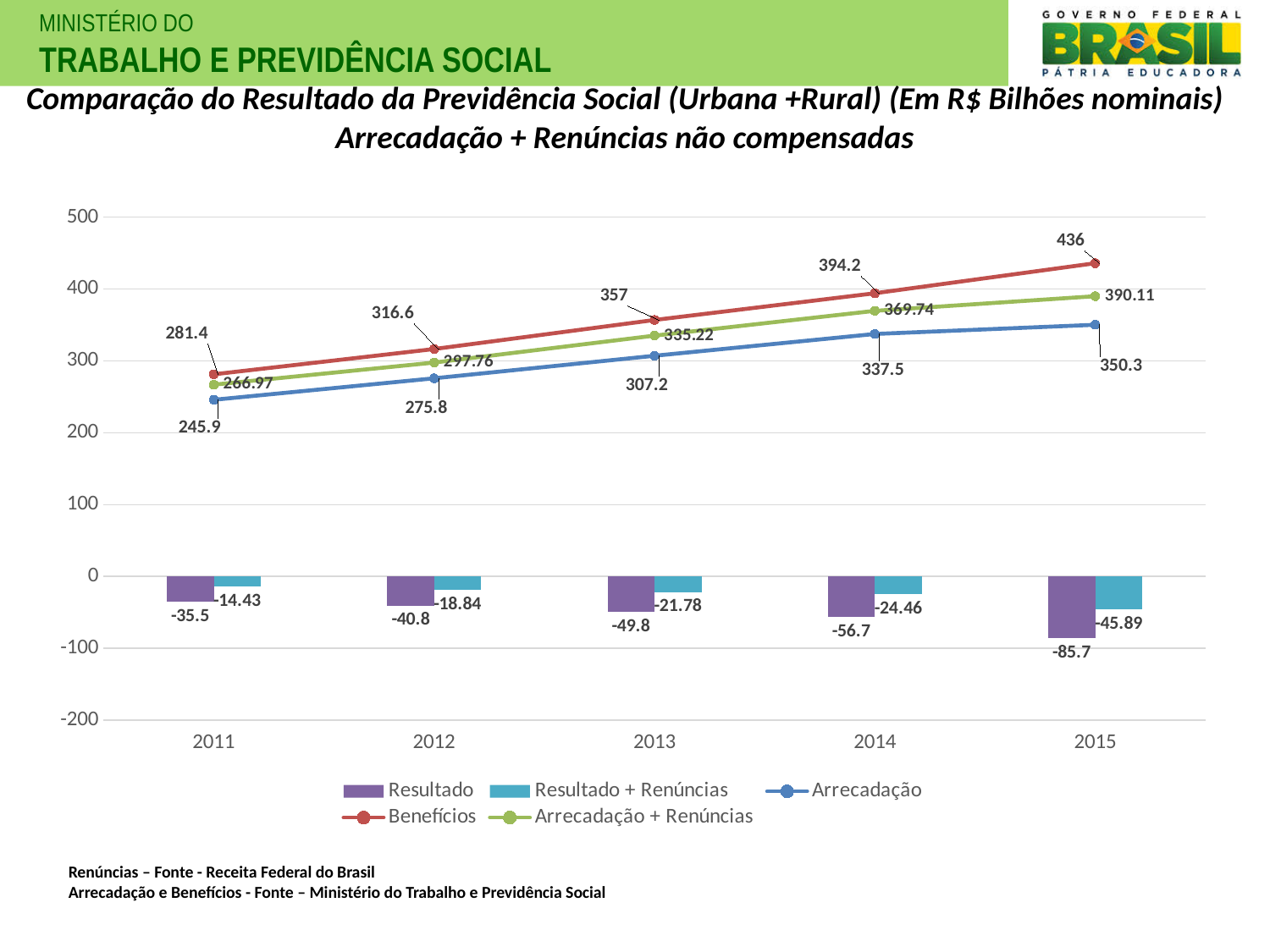
What is the difference between Benefícios and Arrecadação in 2014? 56.7 In which year is Benefícios highest? 2015 What is the value of Arrecadação in 2011? 245.9 What is the value of Benefícios in 2015? 436 Which is larger in 2012: Benefícios or Arrecadação + Renúncias? Benefícios How many series does the legend list? 5 What is the value of Arrecadação + Renúncias in 2013? 335.22 How many years are shown on the x axis? 5 Does the Arrecadação series rise or fall from 2011 to 2015? rise What is the value of Resultado + Renúncias in 2012? -18.84 What is the value of Resultado in 2015? -85.7 In which year is Resultado lowest (most negative)? 2015